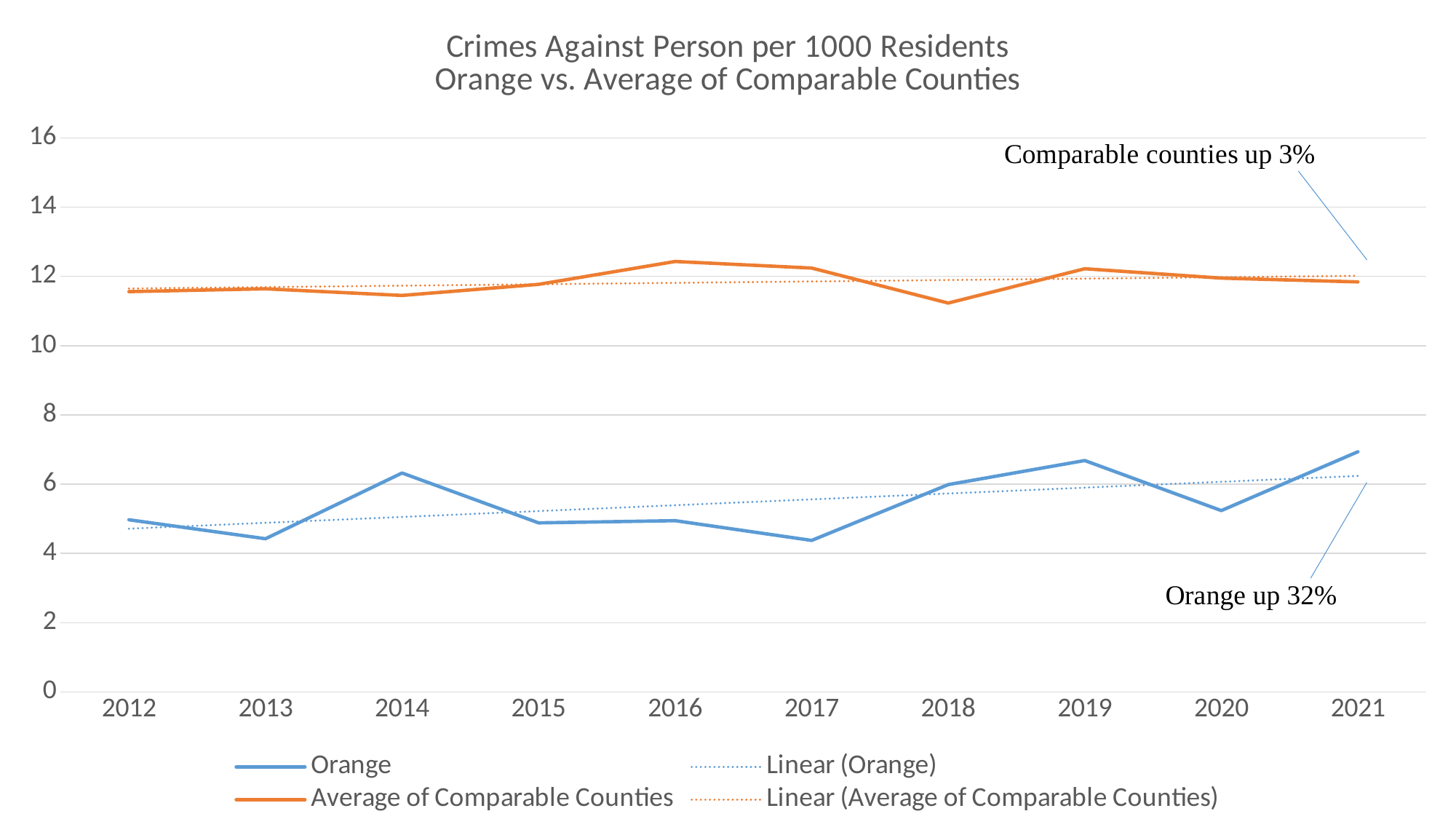
What kind of chart is shown on the slide? line chart How many years are shown on the x axis? 10 Which is larger, the Orange value in 2014 or the Orange value in 2013? 2014 In which year is the Average of Comparable Counties line at its lowest? 2018 Is the value for Average of Comparable Counties in 2018 greater or less than 12? less Is the value for Average of Comparable Counties in 2016 greater or less than 12? greater Is the value for Orange in 2014 greater or less than 6? greater Which series has the higher value in 2021, Orange or Average of Comparable Counties? Average of Comparable Counties Does the Linear (Orange) trend line rise or fall from 2012 to 2021? rise How many series does the legend list? 4 According to the annotation on the chart, by what percentage is Orange up? 32%